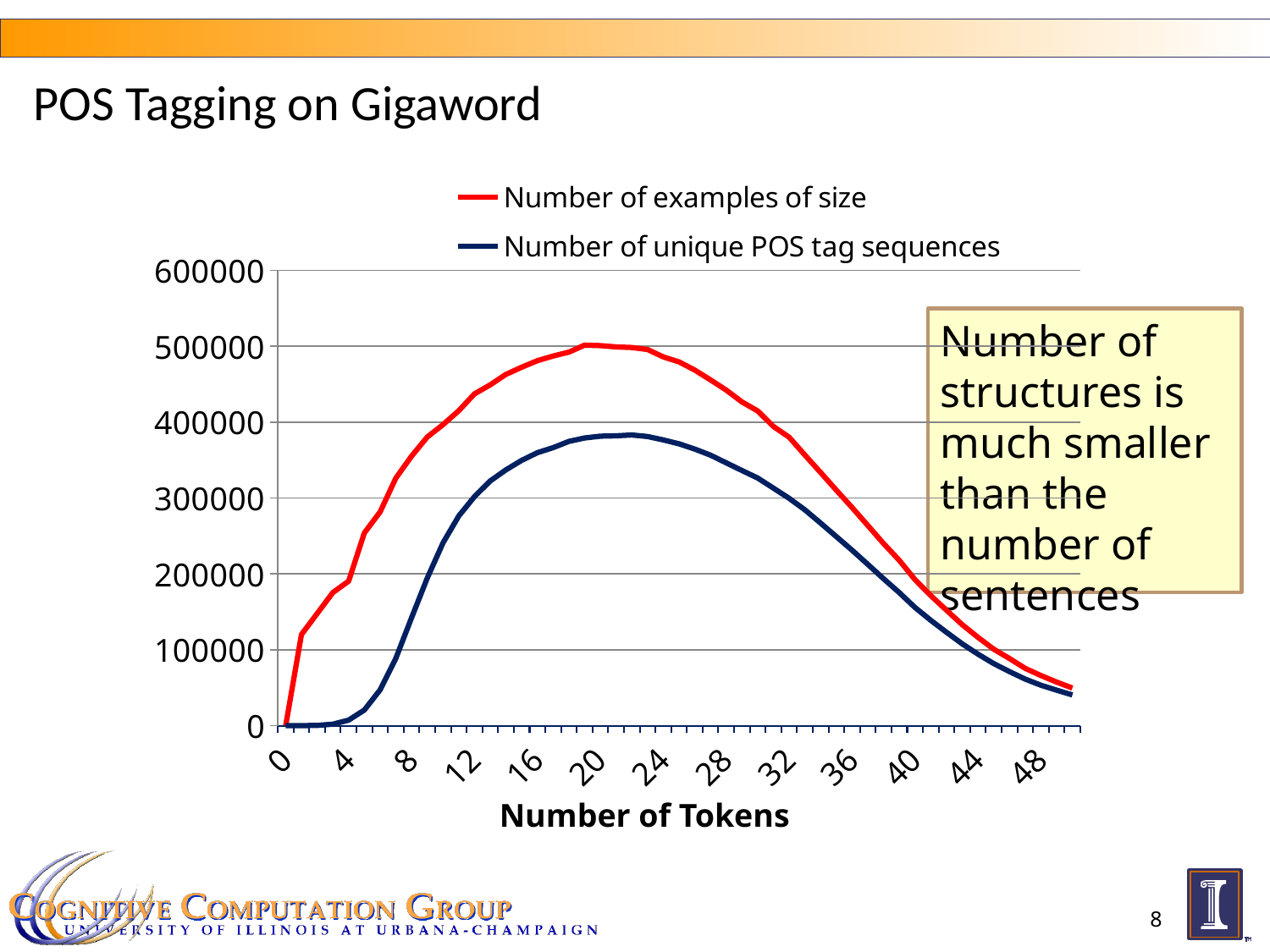
Is the value of 'Number of examples of size' at 8 tokens greater or less than 300000? greater At 20 tokens, which series has the larger value: 'Number of examples of size' or 'Number of unique POS tag sequences'? Number of examples of size Which series is drawn in red? Number of examples of size Do the values of 'Number of examples of size' rise or fall between 24 and 48 tokens? fall Is the value of 'Number of unique POS tag sequences' at 20 tokens greater or less than 400000? less Which series reaches the higher peak value? Number of examples of size What is the title of the x axis? Number of Tokens Is the value of 'Number of unique POS tag sequences' at 40 tokens greater or less than 200000? less How many series does the legend list? 2 What kind of chart is shown on the slide? line chart